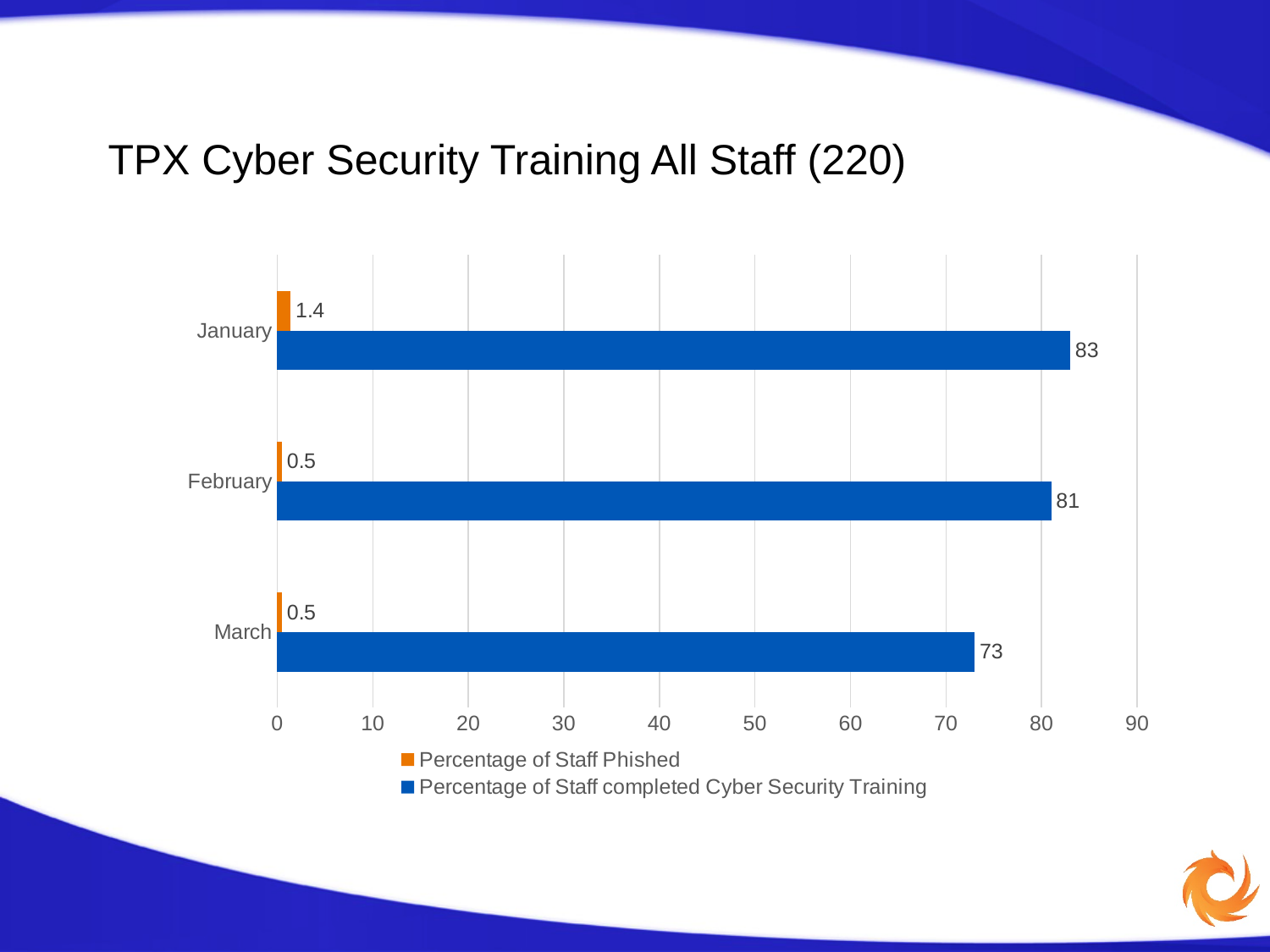
What percentage of staff completed Cyber Security Training in January? 83 How many months are shown on the chart? 3 Which month has the highest percentage of staff completed Cyber Security Training? January What is the difference between the percentage of staff completed Cyber Security Training in January and in March? 10 What percentage of staff completed Cyber Security Training in March? 73 Which month has the highest percentage of staff phished? January What type of chart is shown on the slide? Bar chart What percentage of staff were phished in January? 1.4 Is the percentage of staff completed Cyber Security Training higher in February or in March? February Which month has the lowest percentage of staff completed Cyber Security Training? March What percentage of staff were phished in February? 0.5 How many series does the legend list? 2